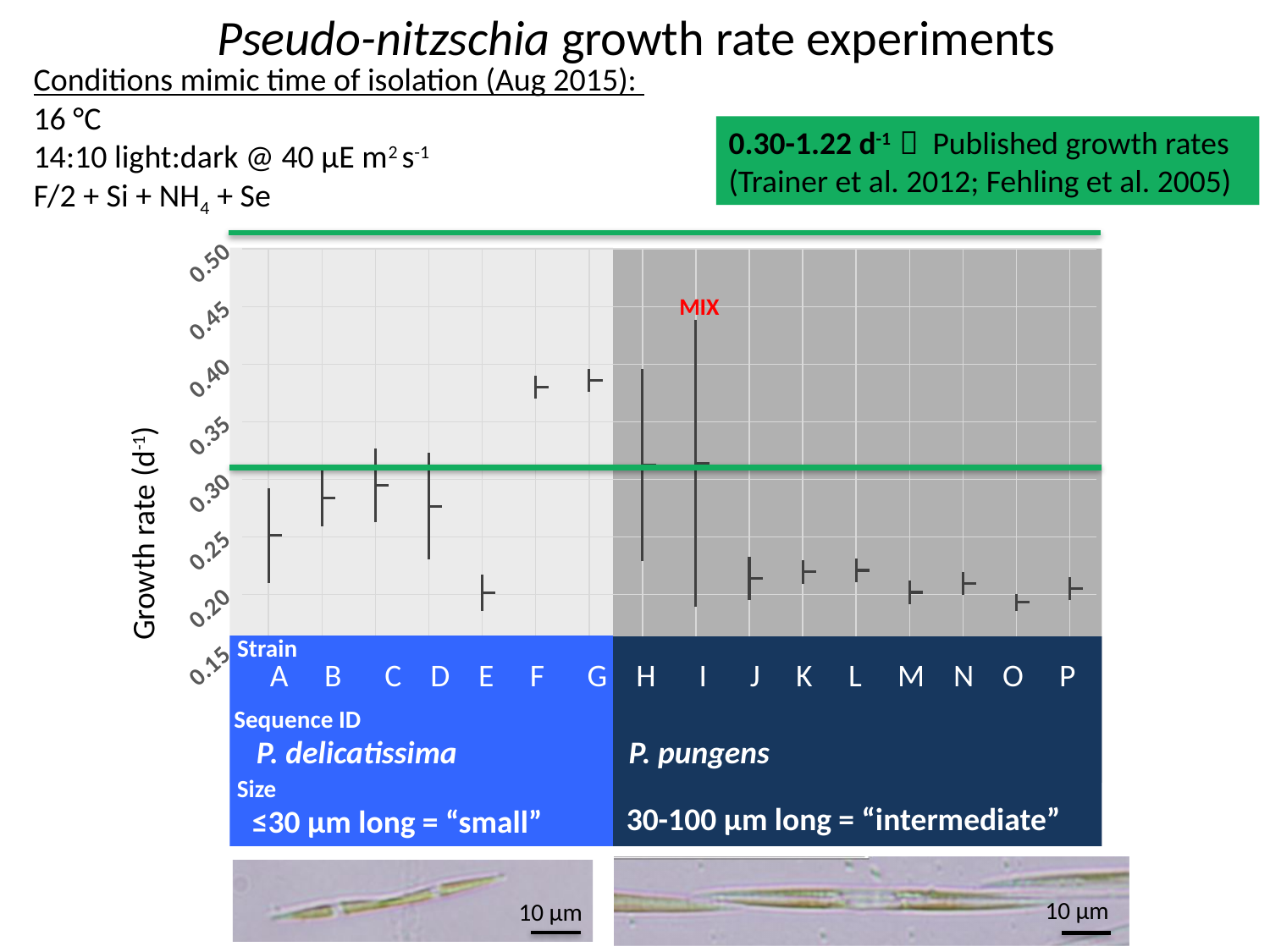
Which strain has the higher growth rate, G or J? G Which strain has the higher growth rate, F or A? F How many strains are plotted on the x axis? 16 Is the growth rate for strain C greater or less than 0.25? greater Is the growth rate for strain J greater or less than 0.25? less Is the growth rate for strain E greater or less than 0.25? less Which strain has the higher growth rate, E or C? C What is the label of the y axis? Growth rate (d-1) Which strain is labelled "MIX" on the chart? I